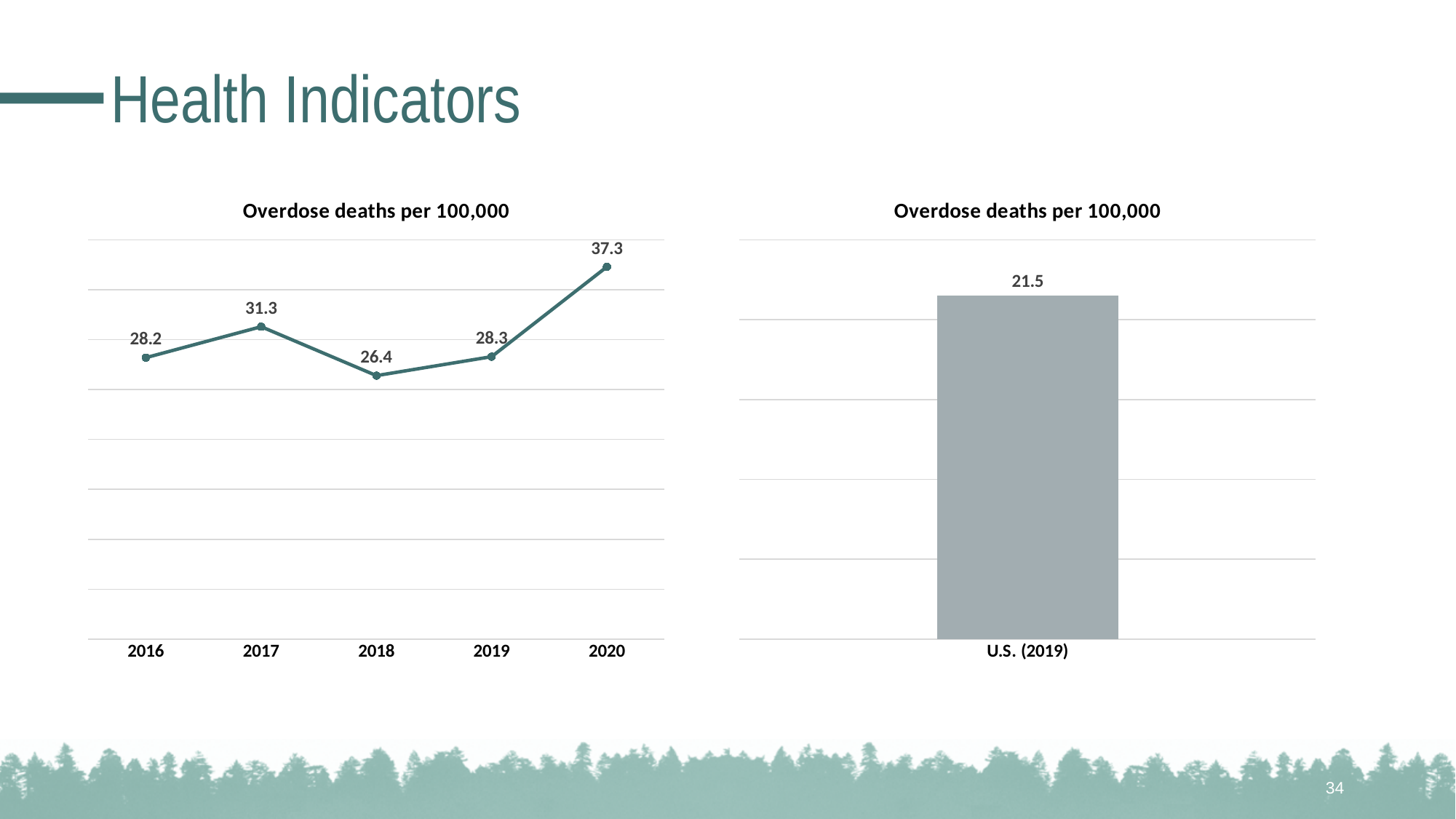
How many data points are plotted in the left chart? 5 In the left chart, which year has the highest value? 2020 What kind of chart is the chart on the left? line chart What kind of chart is the chart on the right? bar chart In the left chart, which is larger: the value for 2017 or the value for 2019? 2017 In the left chart, what is the value for 2020? 37.3 In the left chart, what is the difference between the 2020 value and the 2018 value? 10.9 In the right chart, what is the value for U.S. (2019)? 21.5 In the left chart, which year has the lowest value? 2018 In the left chart, what is the difference between the 2017 value and the 2016 value? 3.1 In the left chart, what is the value for 2018? 26.4 Which is larger: the 2019 value in the left chart or the U.S. (2019) value in the right chart? 2019 value in the left chart